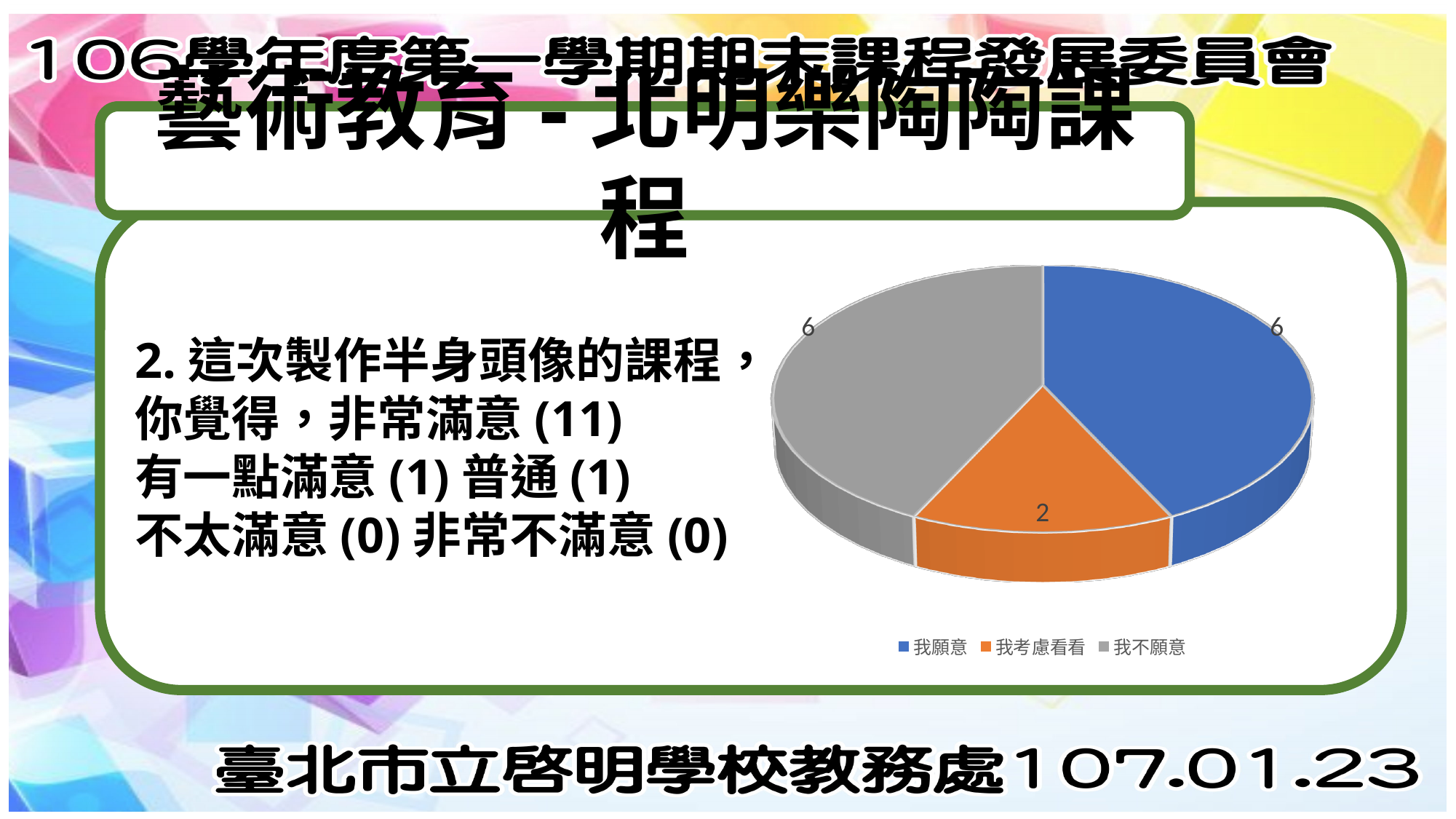
What colour is the 我考慮看看 slice in the pie chart? Orange What value is shown for the 我願意 slice of the pie chart? 6 What is the total of all the values shown on the pie chart? 14 How many slices does the pie chart have? 3 Which is larger, the value for 我不願意 or the value for 我考慮看看? 我不願意 What is the difference between the values for 我願意 and 我考慮看看? 4 What value is shown for the 我不願意 slice of the pie chart? 6 What value is shown for the 我考慮看看 slice of the pie chart? 2 Which category has the smallest slice in the pie chart? 我考慮看看 What share of the total does the 我考慮看看 slice represent? 2 out of 14 What kind of chart is shown on the slide? Pie chart How many entries does the legend of the pie chart list? 3